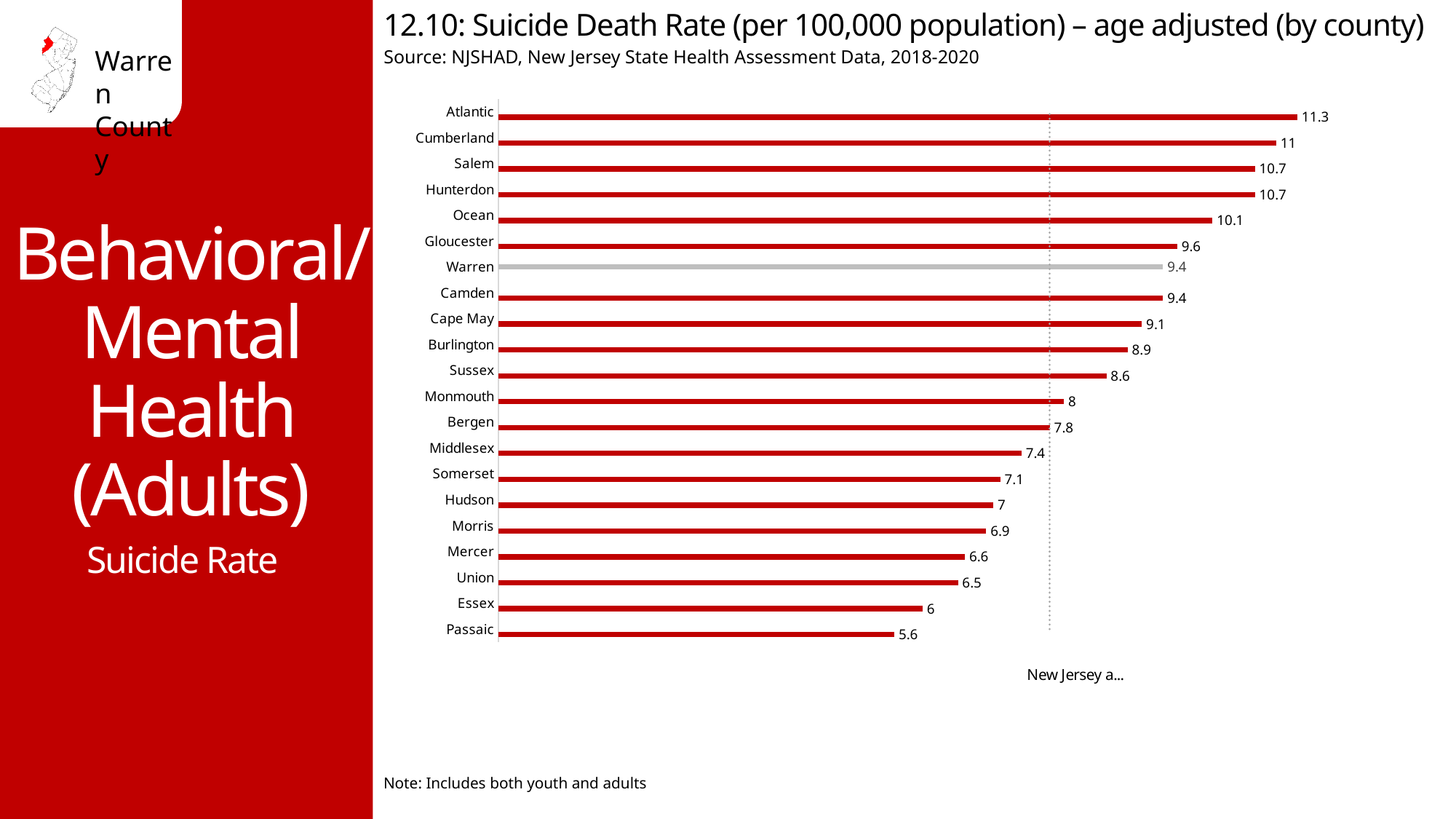
Which county has the lowest suicide death rate? Passaic What is the suicide death rate for Hudson County? 7 How many counties are shown in the chart? 21 What is the suicide death rate for Passaic County? 5.6 Which county's bar is shown in grey rather than red? Warren What is the difference between the suicide death rates of Gloucester and Warren counties? 0.2 What kind of chart is shown on the slide? Bar chart Which county has a higher suicide death rate, Ocean or Bergen? Ocean What is the suicide death rate for Atlantic County? 11.3 Which county has the highest suicide death rate? Atlantic What is the difference between the suicide death rates of Atlantic and Passaic counties? 5.7 What is the suicide death rate for Warren County? 9.4